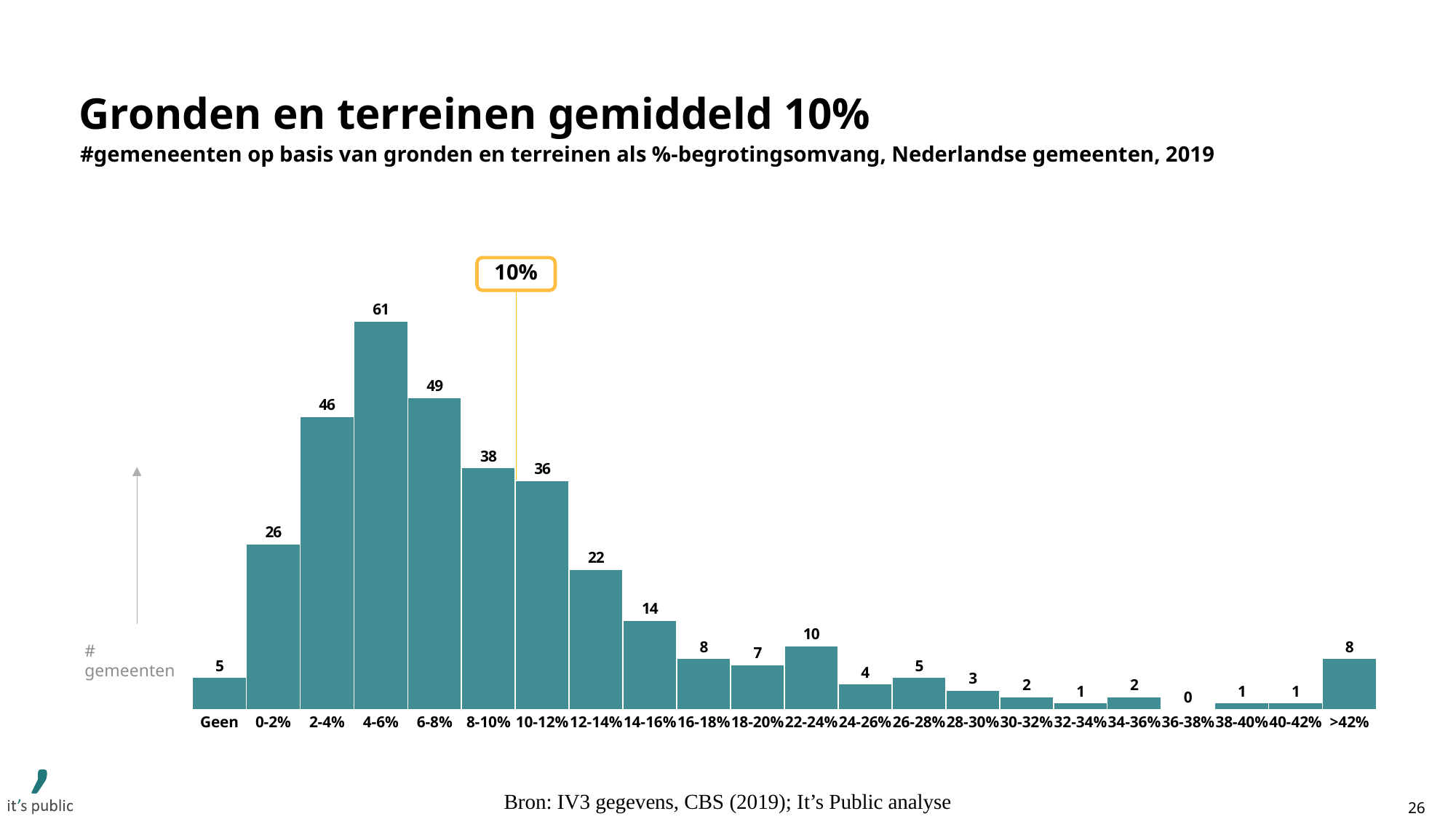
What is the value for the 10-12% category? 36 What is the value for the >42% category? 8 Which category has the lowest value? 36-38% Which is larger, the value for 8-10% or the value for 12-14%? 8-10% What is the difference between the values for 4-6% and 6-8%? 12 How many categories are shown on the x axis? 22 Which category has the highest value? 4-6% How many gemeenten are in the 'Geen' category? 5 What is the difference between the values for 0-2% and 2-4%? 20 What is the value for the 4-6% category? 61 What value is shown in the highlighted box above the chart? 10% What kind of chart is shown on the slide? Bar chart